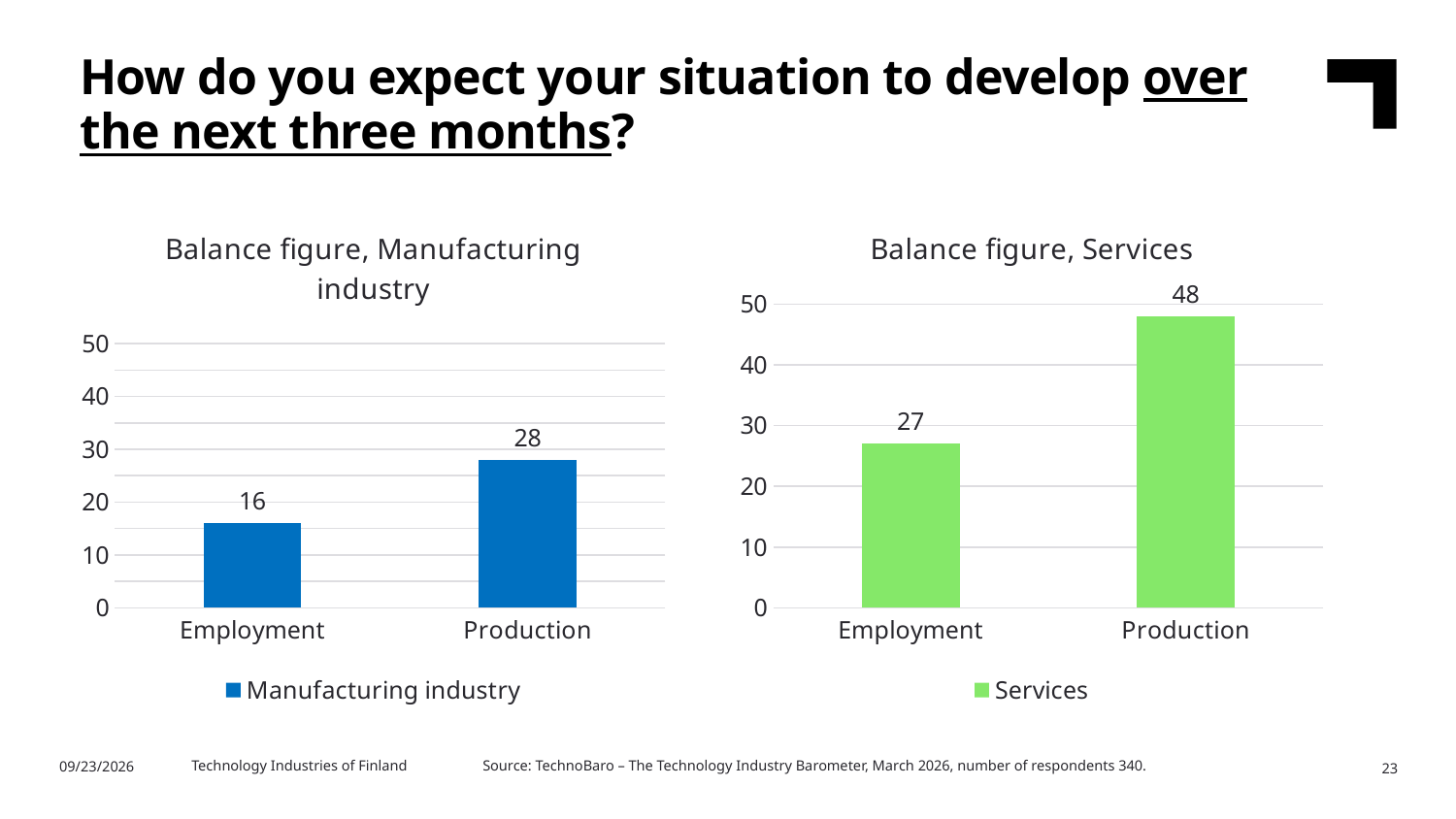
In the 'Balance figure, Services' chart, which category has the highest value? Production What type of chart is the 'Balance figure, Services' chart? Bar chart In the 'Balance figure, Manufacturing industry' chart, which category has the lowest value? Employment In the 'Balance figure, Manufacturing industry' chart, what is the value for Employment? 16 How many categories are shown in the 'Balance figure, Manufacturing industry' chart? 2 In the 'Balance figure, Services' chart, what is the value for Employment? 27 In the 'Balance figure, Manufacturing industry' chart, what is the value for Production? 28 In the 'Balance figure, Services' chart, what is the value for Production? 48 In the 'Balance figure, Services' chart, what is the difference between the Production and Employment values? 21 Which is larger: the Employment value in the Manufacturing industry chart or the Employment value in the Services chart? Services In the 'Balance figure, Manufacturing industry' chart, what is the difference between the Production and Employment values? 12 In the 'Balance figure, Services' chart, is the value for Production greater or less than 40? greater